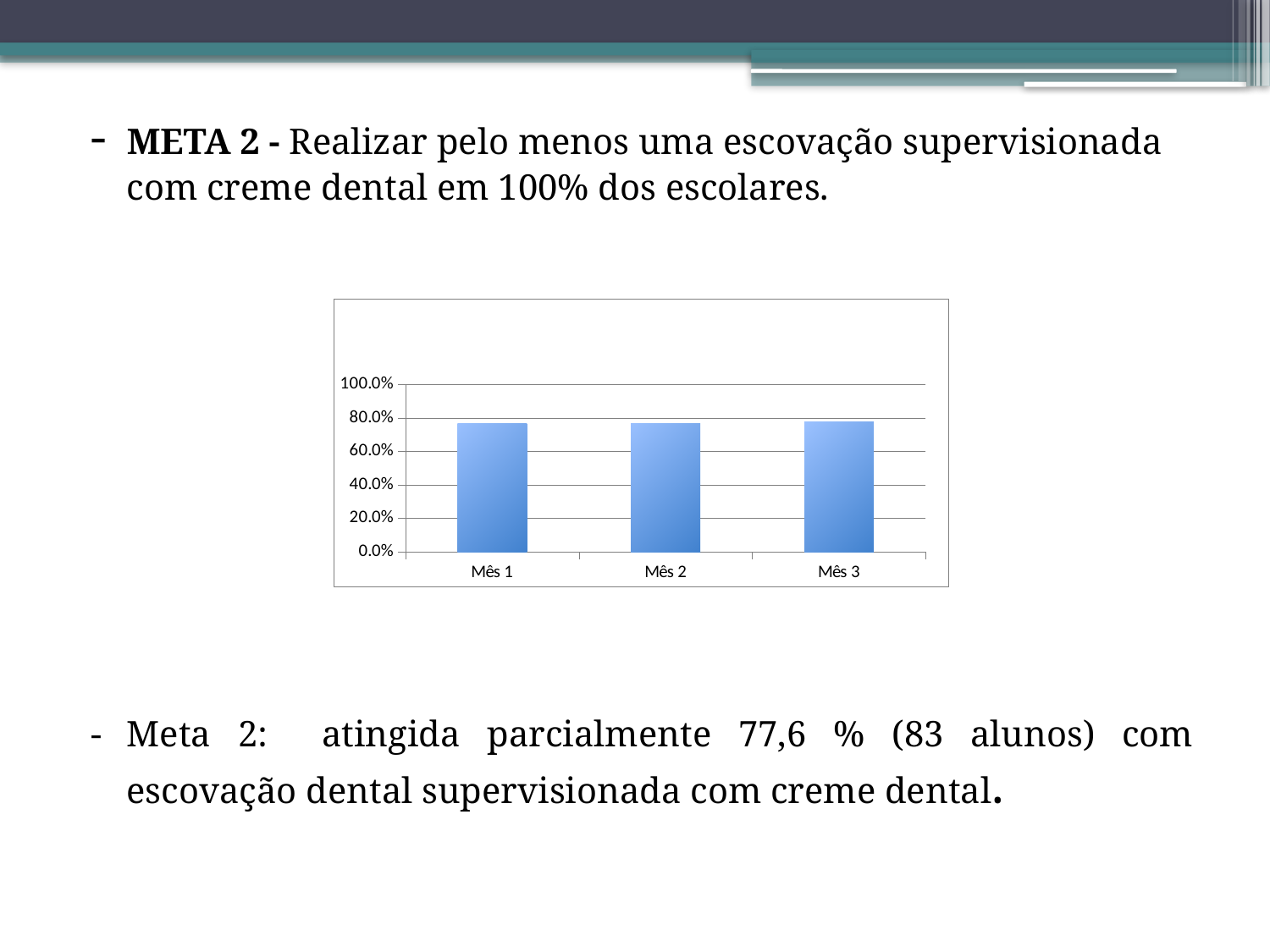
What colour are the bars in the chart? blue Is the value for Mês 1 greater or less than 80.0%? less What kind of chart is shown on the slide? bar chart Is the value for Mês 1 greater or less than 40.0%? greater Is the value for Mês 3 greater or less than 80.0%? less What is the label of the first category on the x axis? Mês 1 Do the values rise, fall, or stay roughly the same from Mês 1 to Mês 3? stay roughly the same What is the highest value shown on the y axis of the chart? 100.0% How many categories are plotted on the x axis of the chart? 3